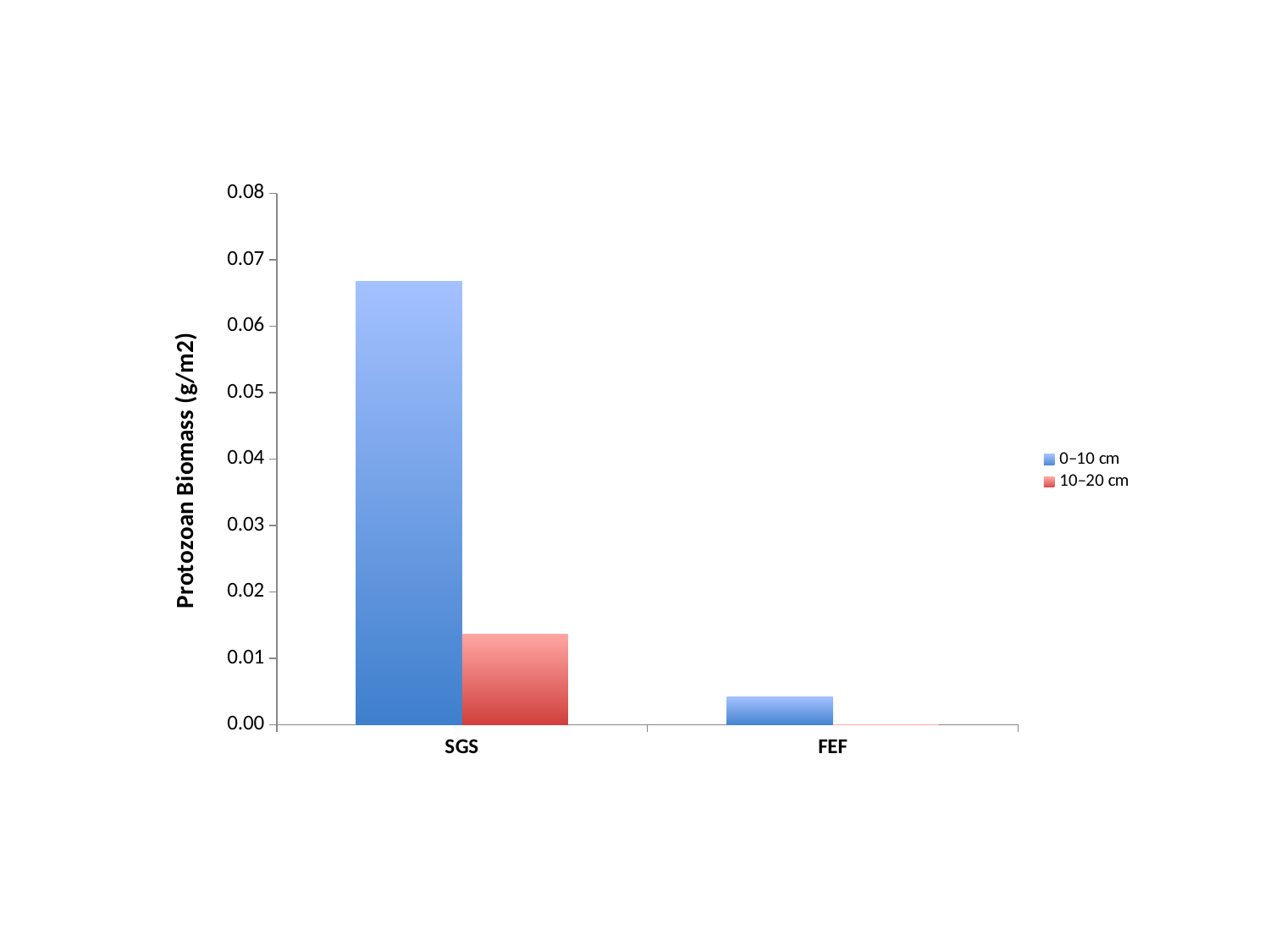
Is the 0–10 cm value for SGS greater or less than 0.06? greater What kind of chart is shown on the slide? bar chart Which colour represents the 10–20 cm series? red Which category has the highest protozoan biomass for the 0–10 cm series? SGS Which is larger for the 0–10 cm series: SGS or FEF? SGS How many series does the legend list? 2 Which is larger for SGS: the 0–10 cm value or the 10–20 cm value? 0–10 cm Is the 10–20 cm value for SGS greater or less than 0.02? less Which category has the lowest protozoan biomass for the 10–20 cm series? FEF What is the label of the y axis? Protozoan Biomass (g/m2) How many categories are shown on the x axis? 2 Is the 0–10 cm value for FEF greater or less than 0.01? less